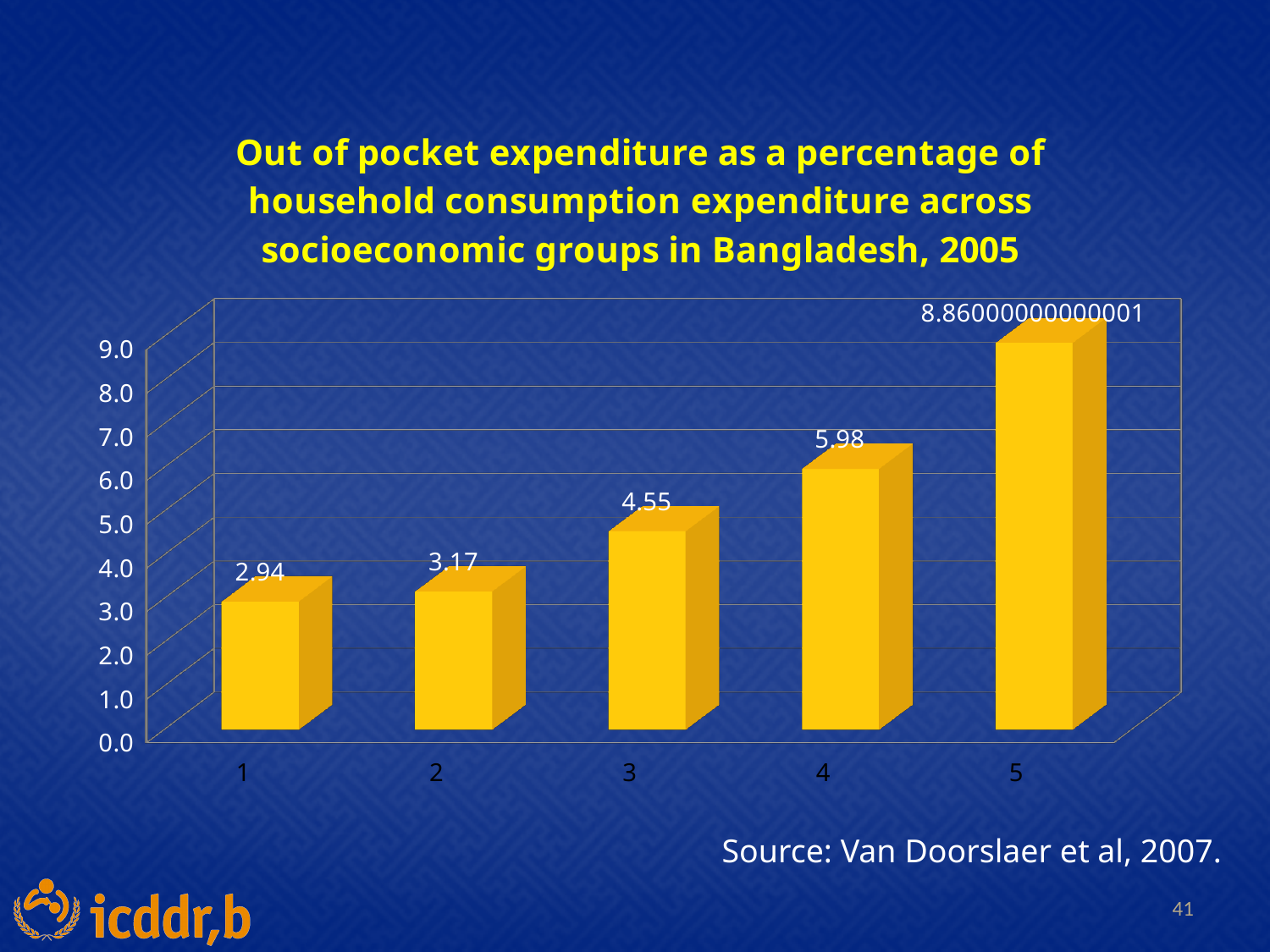
What is the value for socioeconomic group 1? 2.94 Which socioeconomic group has the lowest value? 1 Do the values rise or fall from group 1 to group 5? rise Which socioeconomic group has the highest out of pocket expenditure share? 5 What data label is shown on the bar for group 5? 8.86000000000001 What is the difference between the values for group 4 and group 3? 1.43 Which is larger, the value for group 2 or the value for group 4? group 4 Is the value for group 5 greater or less than 8.0? greater What is the value for socioeconomic group 3? 4.55 What is the difference between the values for group 2 and group 1? 0.23 How many socioeconomic groups are shown on the x axis? 5 What kind of chart is shown on the slide? bar chart